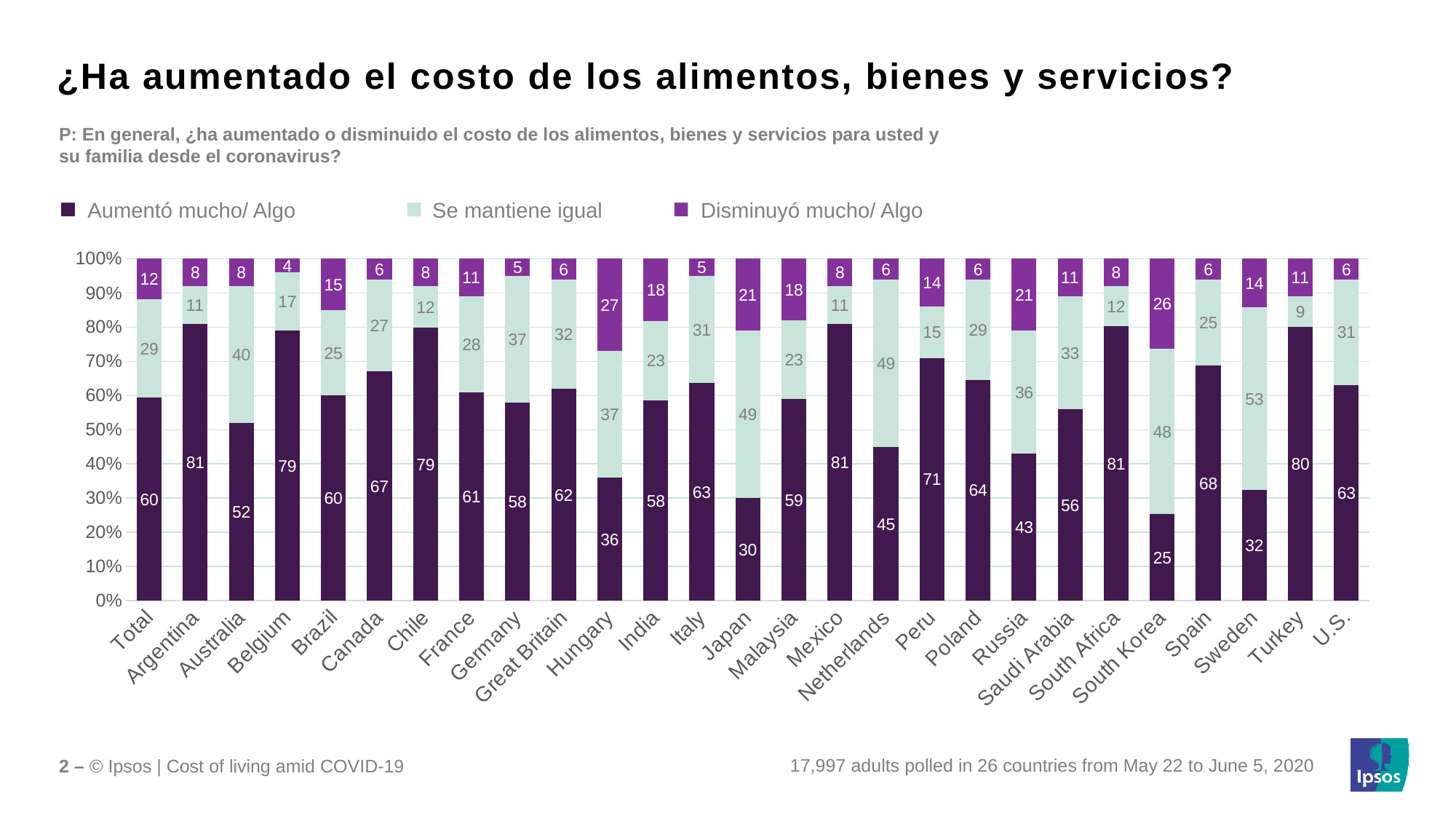
What is the value for 'Se mantiene igual' in Sweden? 53 What kind of chart is shown on the slide? Stacked bar chart Which country has the lowest value for 'Aumentó mucho/ Algo'? South Korea Which country has the lowest value for 'Disminuyó mucho/ Algo'? Belgium How many categories (countries plus Total) are shown on the x axis? 27 What is the difference between the 'Aumentó mucho/ Algo' values for Turkey and Sweden? 48 Which country has the highest value for 'Se mantiene igual'? Sweden How many series does the legend list? 3 What is the 'Aumentó mucho/ Algo' value for the Total bar? 60 Which has a larger 'Aumentó mucho/ Algo' value, Canada or Peru? Peru What is the value for 'Disminuyó mucho/ Algo' in Hungary? 27 What percentage of respondents in Japan said the cost increased (Aumentó mucho/ Algo)? 30